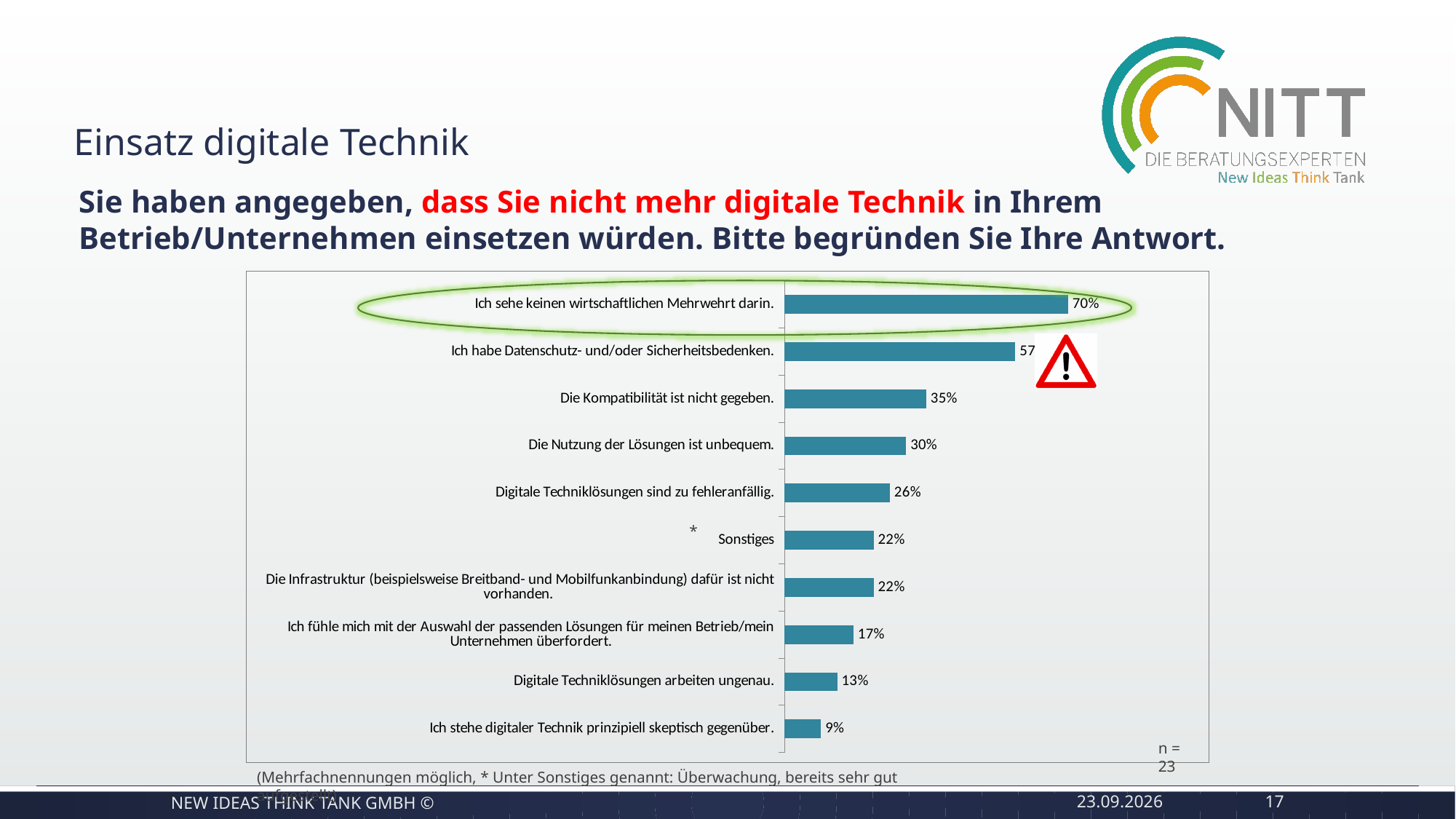
How many categories are plotted in the chart? 10 Which category has the lowest value in the chart? Ich stehe digitaler Technik prinzipiell skeptisch gegenüber. What percentage is shown for "Sonstiges"? 22% Which is larger: the value for "Digitale Techniklösungen sind zu fehleranfällig." or for "Digitale Techniklösungen arbeiten ungenau."? Digitale Techniklösungen sind zu fehleranfällig. Which category has the highest value in the chart? Ich sehe keinen wirtschaftlichen Mehrwehrt darin. What percentage is shown for "Die Kompatibilität ist nicht gegeben."? 35% What is the difference between the values for "Die Kompatibilität ist nicht gegeben." and "Die Nutzung der Lösungen ist unbequem."? 5% What sample size (n) is given for the chart? n = 23 What percentage is shown for "Ich stehe digitaler Technik prinzipiell skeptisch gegenüber."? 9% What percentage is shown for "Die Nutzung der Lösungen ist unbequem."? 30% What kind of chart is shown on the slide? bar chart What percentage is shown for "Ich sehe keinen wirtschaftlichen Mehrwehrt darin."? 70%